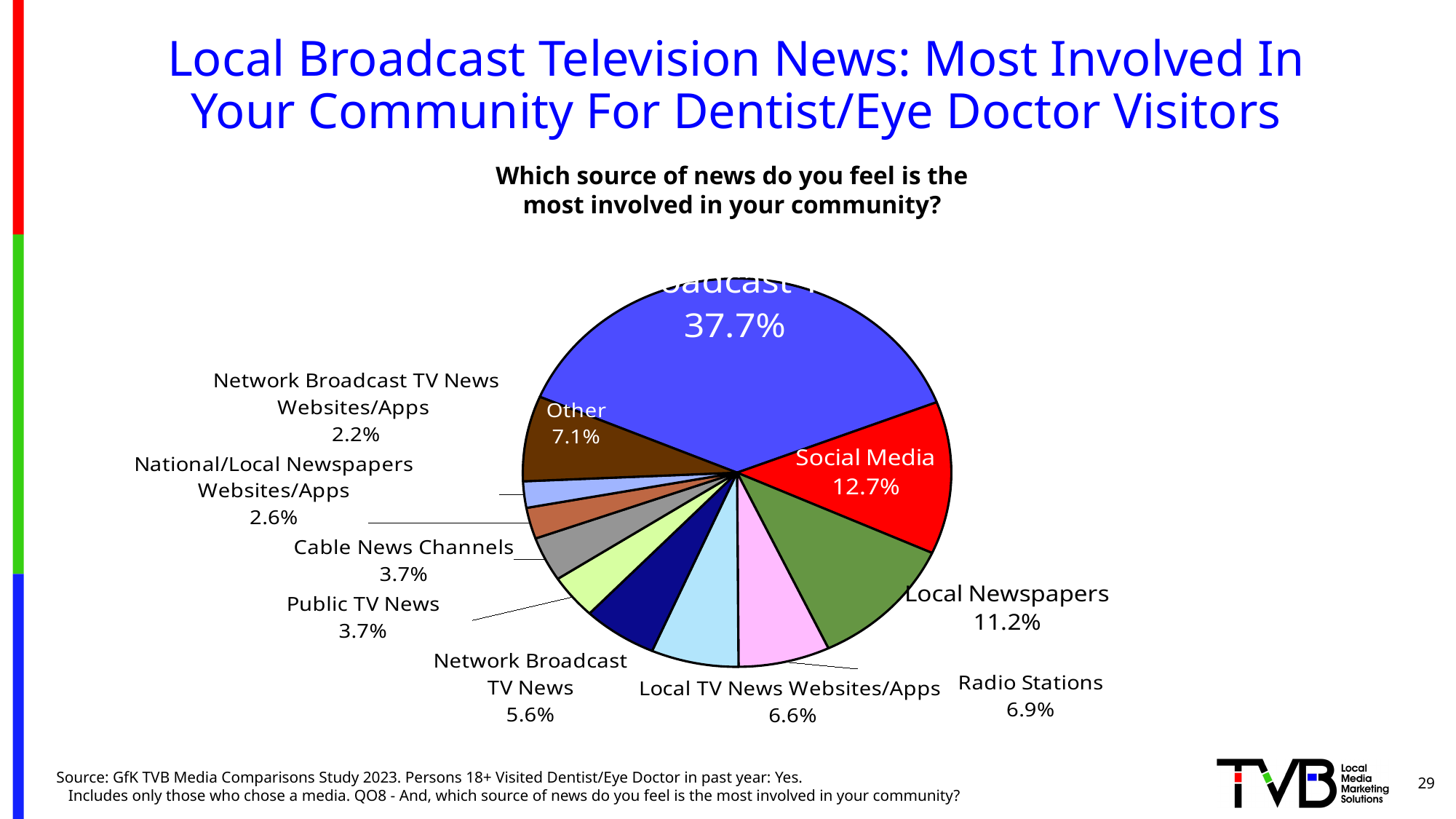
What is the value shown for Local TV News Websites/Apps? 6.6% What is the value shown for Radio Stations? 6.9% Which is larger, Social Media or Local Newspapers? Social Media What is the difference between the Radio Stations value and the Local TV News Websites/Apps value? 0.3% How many slices does the pie chart have? 11 What is the value shown for Local Newspapers? 11.2% Which labeled category has the smallest slice of the pie? Network Broadcast TV News Websites/Apps What question is shown as the subtitle above the pie chart? Which source of news do you feel is the most involved in your community? What percentage of the pie does Social Media account for? 12.7% What kind of chart is shown on the slide? pie chart What percentage is shown on the largest slice of the pie? 37.7% What is the value shown for the Other slice? 7.1%